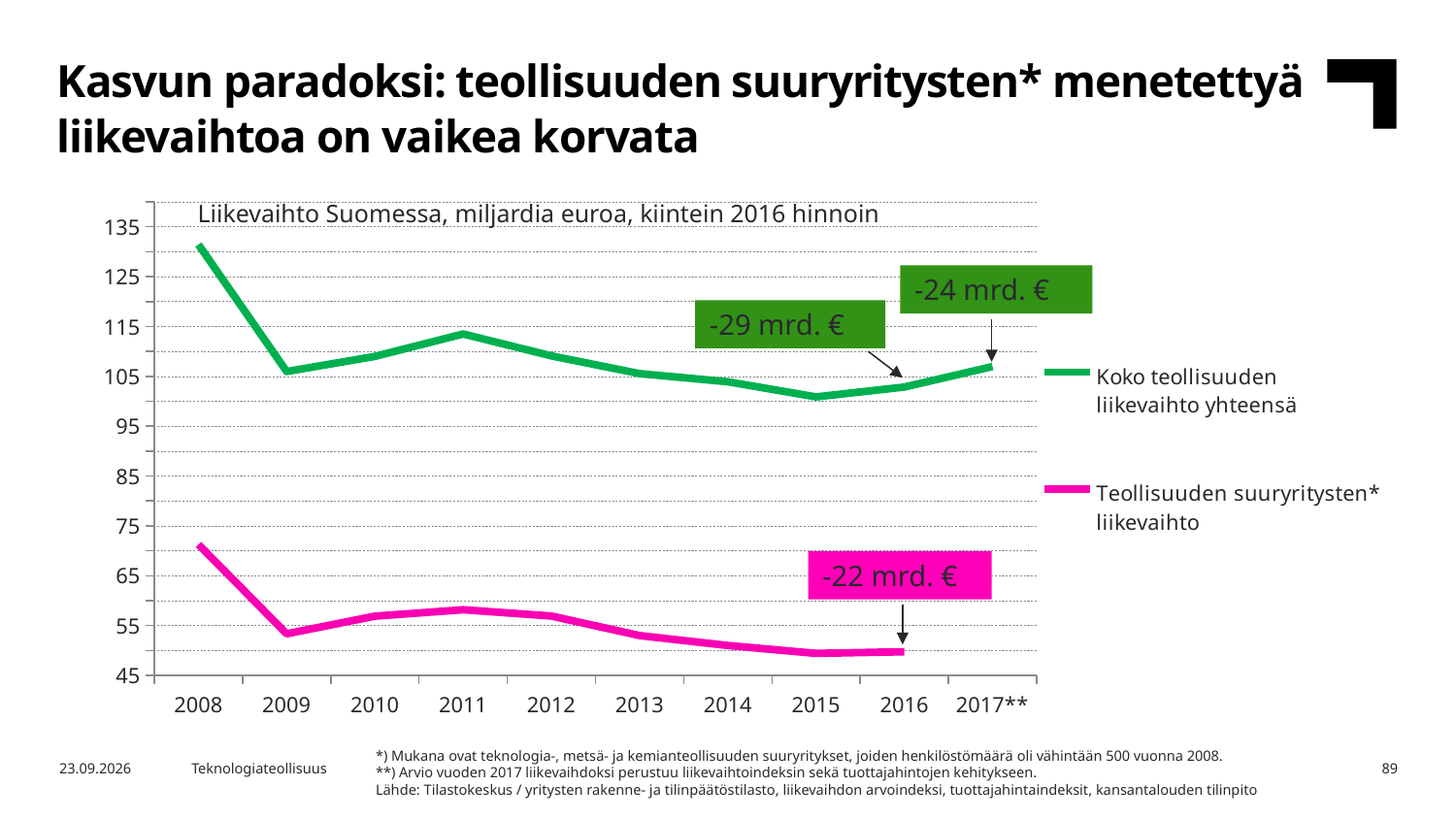
What is the title of the chart? Liikevaihto Suomessa, miljardia euroa, kiintein 2016 hinnoin How many series does the legend list? 2 Is the value for 'Koko teollisuuden liikevaihto yhteensä' in 2008 greater or less than 125? greater What kind of chart is shown on the slide? line chart How many years are shown on the x axis? 10 Is the value for 'Teollisuuden suuryritysten* liikevaihto' in 2015 greater or less than 55? less In which year is 'Koko teollisuuden liikevaihto yhteensä' highest? 2008 Does 'Teollisuuden suuryritysten* liikevaihto' rise or fall from 2008 to 2009? fall What change is annotated on the chart for 'Koko teollisuuden liikevaihto yhteensä' at 2016? -29 mrd. € Which is larger for 'Koko teollisuuden liikevaihto yhteensä': the value in 2009 or in 2011? 2011 Is the value for 'Koko teollisuuden liikevaihto yhteensä' in 2009 greater or less than 115? less In which year is 'Teollisuuden suuryritysten* liikevaihto' highest? 2008